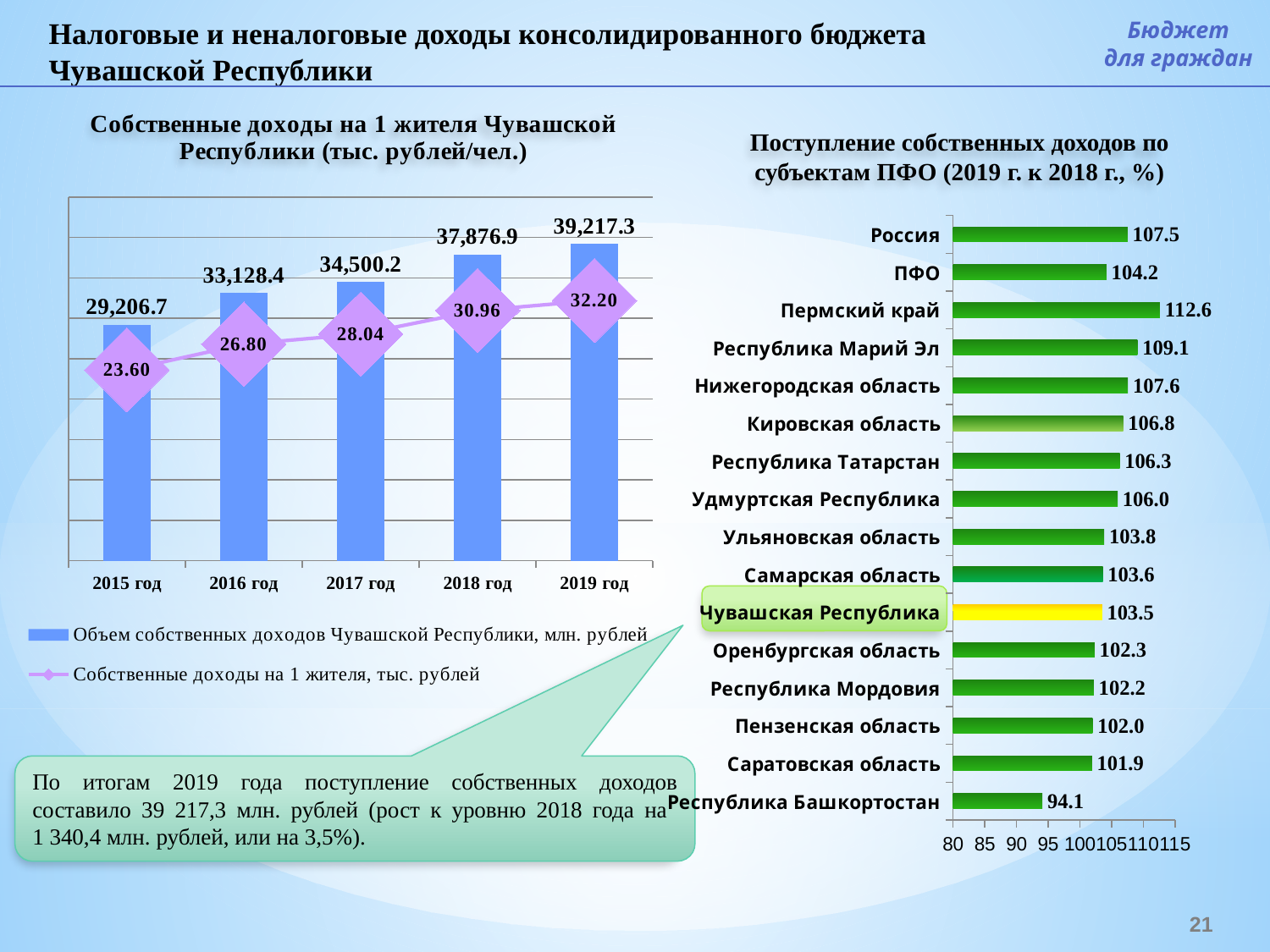
On the left chart, how many series does the legend list? 2 On the right chart, which is larger: the value for Республика Марий Эл or the value for Нижегородская область? Республика Марий Эл What type of chart is the right chart (Поступление собственных доходов по субъектам ПФО)? bar chart On the right chart (Поступление собственных доходов по субъектам ПФО), which subject has the highest value? Пермский край On the right chart, what is the value for Чувашская Республика? 103.5 On the left chart, do the bar values rise or fall from 2015 год to 2019 год? rise On the left chart, what is the value of the line marker (Собственные доходы на 1 жителя, тыс. рублей) for 2015 год? 23.60 On the left chart (Собственные доходы на 1 жителя Чувашской Республики), what is the value of the bar for 2019 год? 39,217.3 On the left chart, by how much did the bar value (Объем собственных доходов, млн. рублей) increase from 2018 год to 2019 год? 1,340.4 On the left chart, how many years are shown on the x axis? 5 On the right chart, what is the difference between the values for Россия and ПФО? 3.3 On the right chart, which subject has the lowest value? Республика Башкортостан